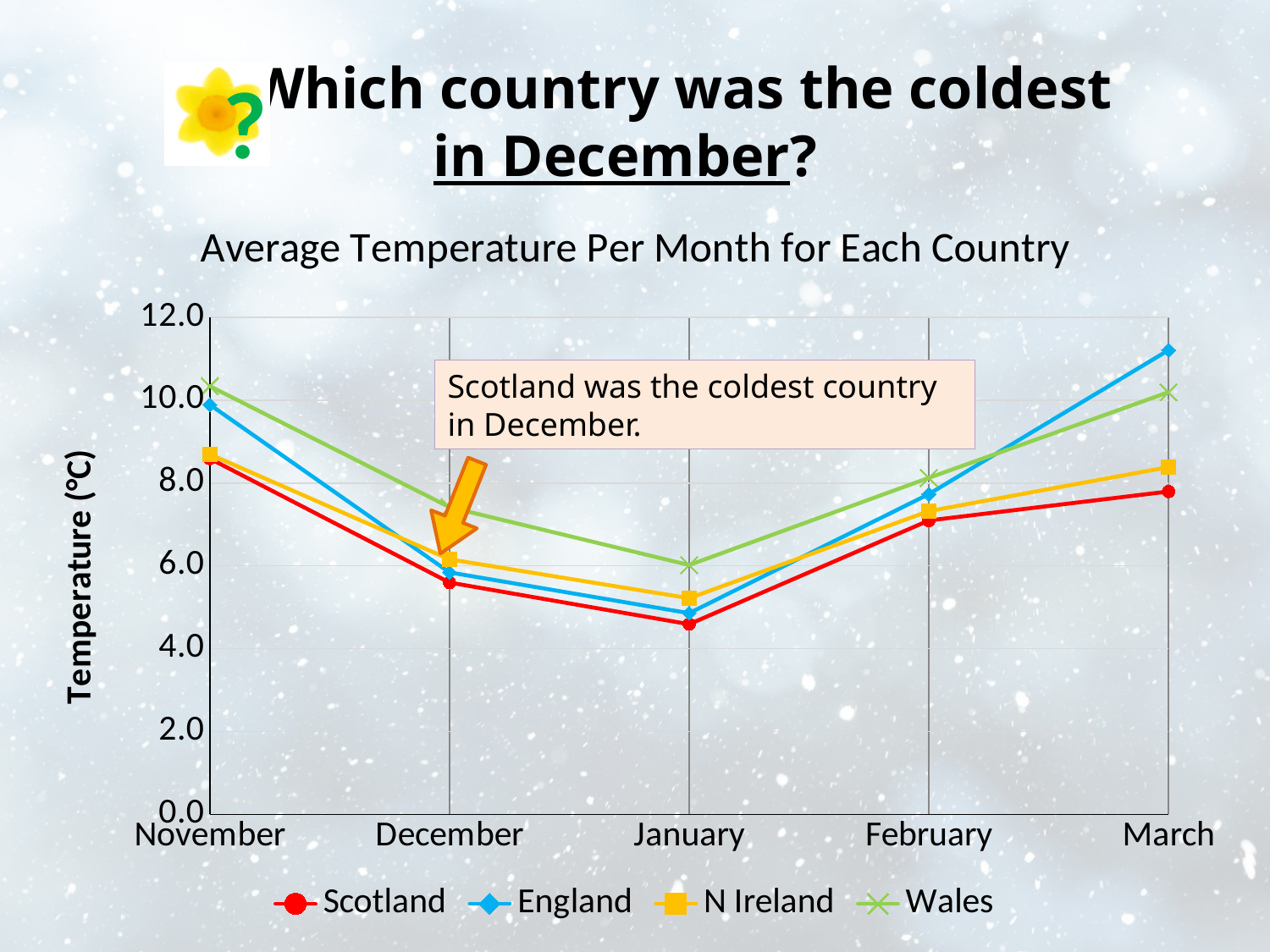
How many series does the legend list? 4 What is the title of the chart? Average Temperature Per Month for Each Country Which country had the highest average temperature in March? England Is the value for Wales in November greater or less than 10.0? greater Which country had the highest average temperature in December? Wales Which is larger, the value for Wales in January or the value for England in January? Wales What kind of chart is shown on the slide? line chart Which country had the lowest average temperature in January? Scotland Do the temperatures for Scotland rise or fall from November to January? fall How many months are shown on the x axis? 5 Is the value for Scotland in January greater or less than 6.0? less Which country had the lowest average temperature in December? Scotland